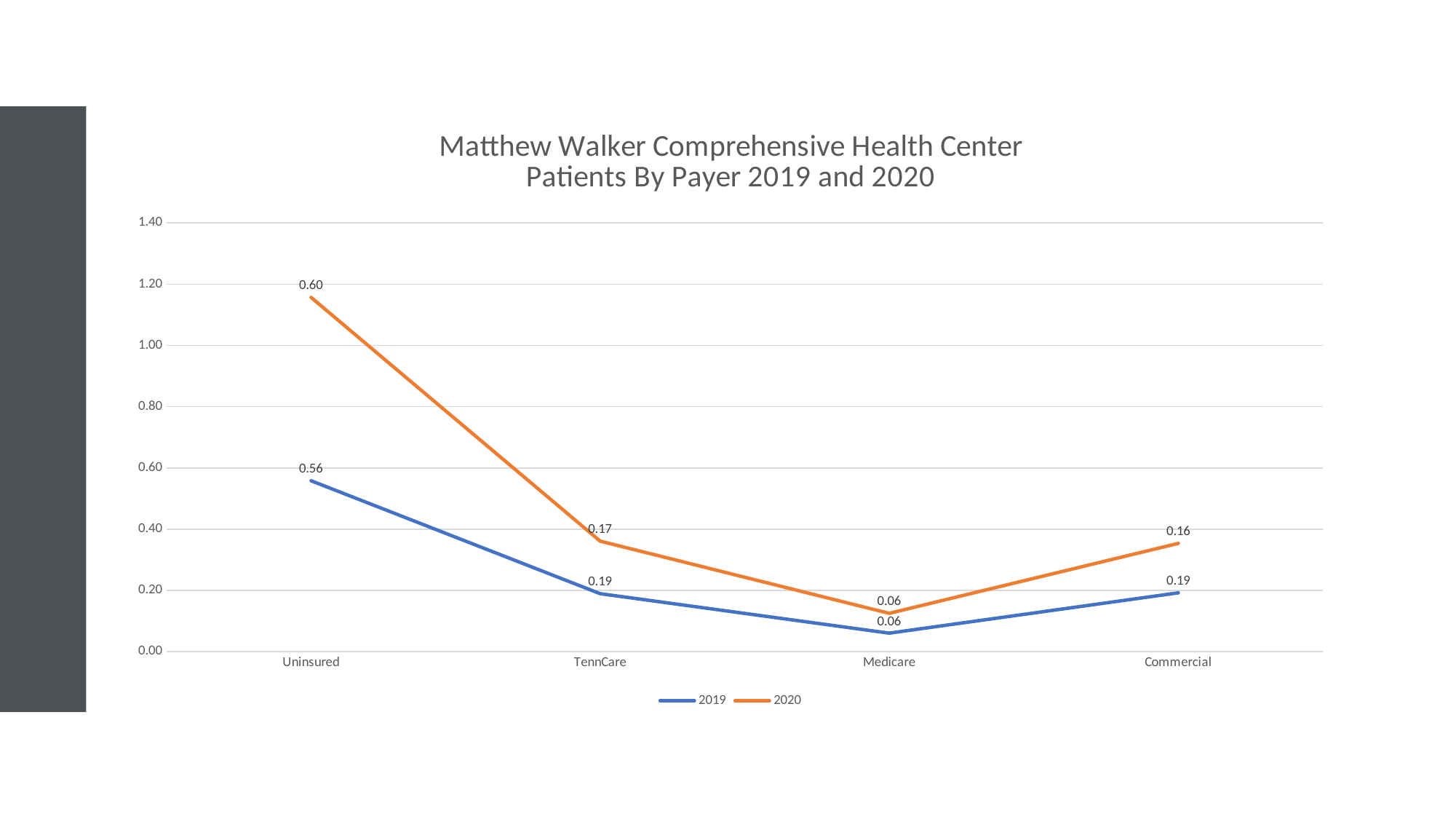
What is the 2020 value for TennCare? 0.17 Which payer category has the lowest 2019 value? Medicare What is the 2019 value for Commercial? 0.19 What kind of chart is shown on the slide? Line chart How many series does the legend list? 2 How many payer categories are shown on the x axis? 4 Which payer category has the highest 2020 value? Uninsured For TennCare, which is larger: the 2019 value or the 2020 value? 2019 What is the difference between the 2020 and 2019 values for Uninsured? 0.04 What is the 2019 value for Uninsured? 0.56 What is the 2020 value for Uninsured? 0.60 Do the 2019 values rise or fall from Uninsured to Medicare? Fall